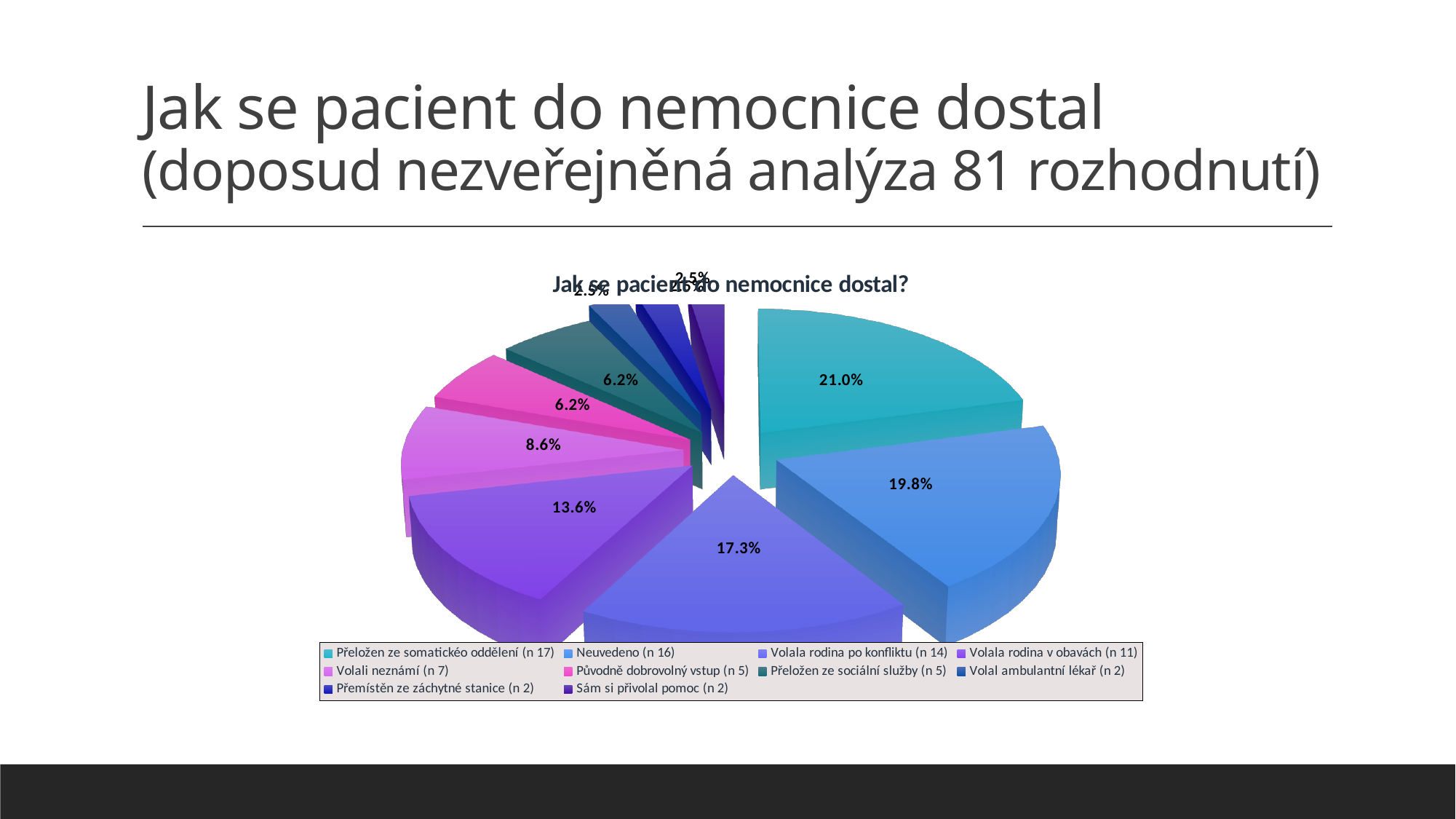
What percentage is shown for "Původně dobrovolný vstup (n 5)"? 6.2% What kind of chart is shown on the slide? Pie chart What is the title of the chart? Jak se pacient do nemocnice dostal? What share of the pie does "Přeložen ze somatickéo oddělení (n 17)" represent? 21.0% What percentage is shown for "Volali neznámí (n 7)"? 8.6% What percentage is shown for "Neuvedeno (n 16)"? 19.8% Which is larger: the share for "Volala rodina v obavách (n 11)" or the share for "Volali neznámí (n 7)"? Volala rodina v obavách (n 11) Which category has the largest share of the pie? Přeložen ze somatickéo oddělení (n 17) What percentage is shown for "Volala rodina po konfliktu (n 14)"? 17.3% What is the difference in percentage points between "Přeložen ze somatickéo oddělení (n 17)" and "Neuvedeno (n 16)"? 1.2 percentage points What percentage is shown for "Volala rodina v obavách (n 11)"? 13.6% How many categories does the legend of the pie chart list? 10